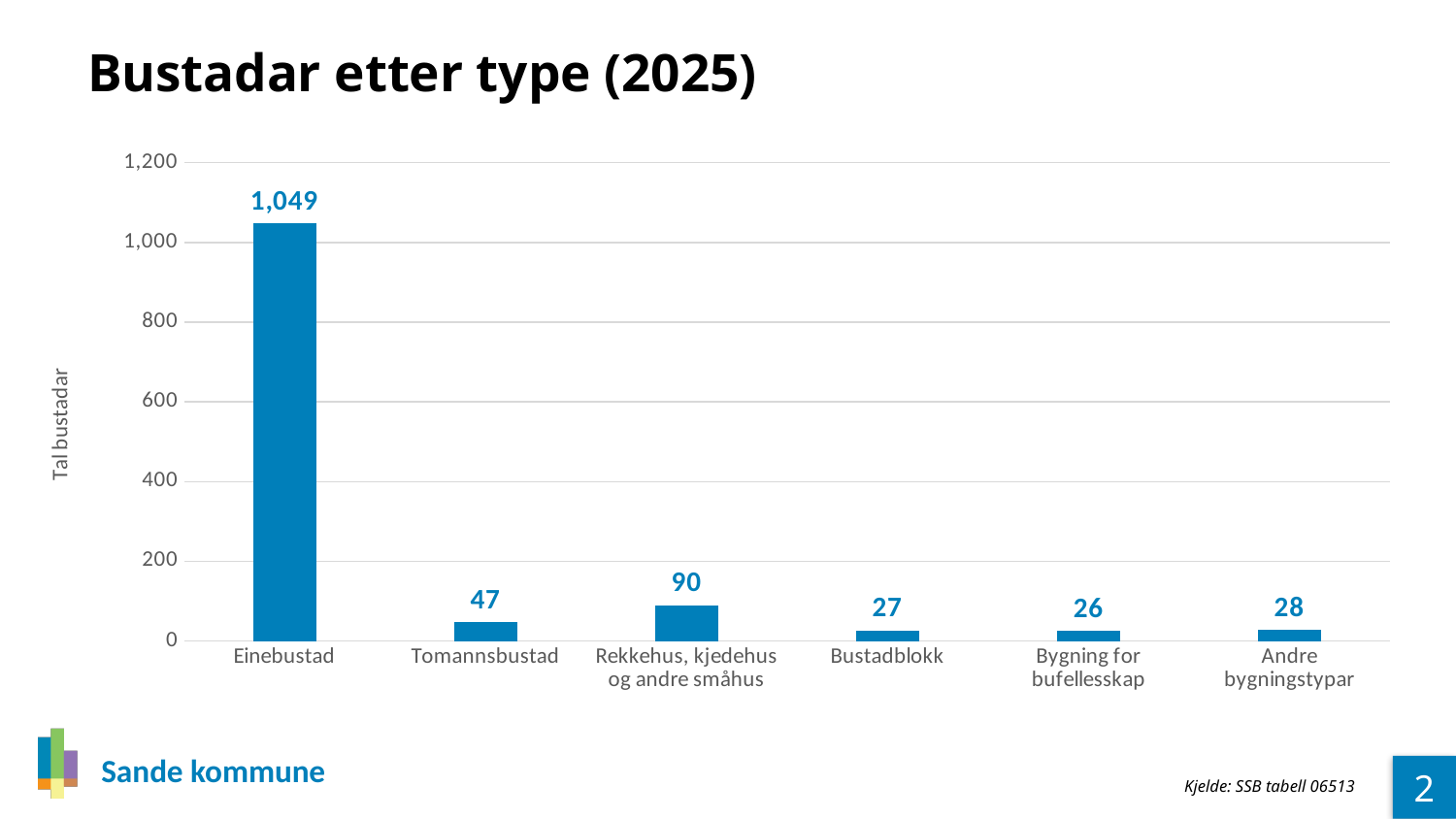
What is the title of the chart? Bustadar etter type (2025) Which is larger, the value for Tomannsbustad or the value for Andre bygningstypar? Tomannsbustad What is the value for Rekkehus, kjedehus og andre småhus? 90 Which category has the lowest value? Bygning for bufellesskap What is the value for Tomannsbustad? 47 What is the value for Bustadblokk? 27 What kind of chart is shown on the slide? bar chart Which category has the highest value? Einebustad What is the difference between the values for Einebustad and Rekkehus, kjedehus og andre småhus? 959 Is the value for Einebustad greater or less than 1,000? greater How many categories are shown on the x axis? 6 What is the value for Einebustad? 1,049